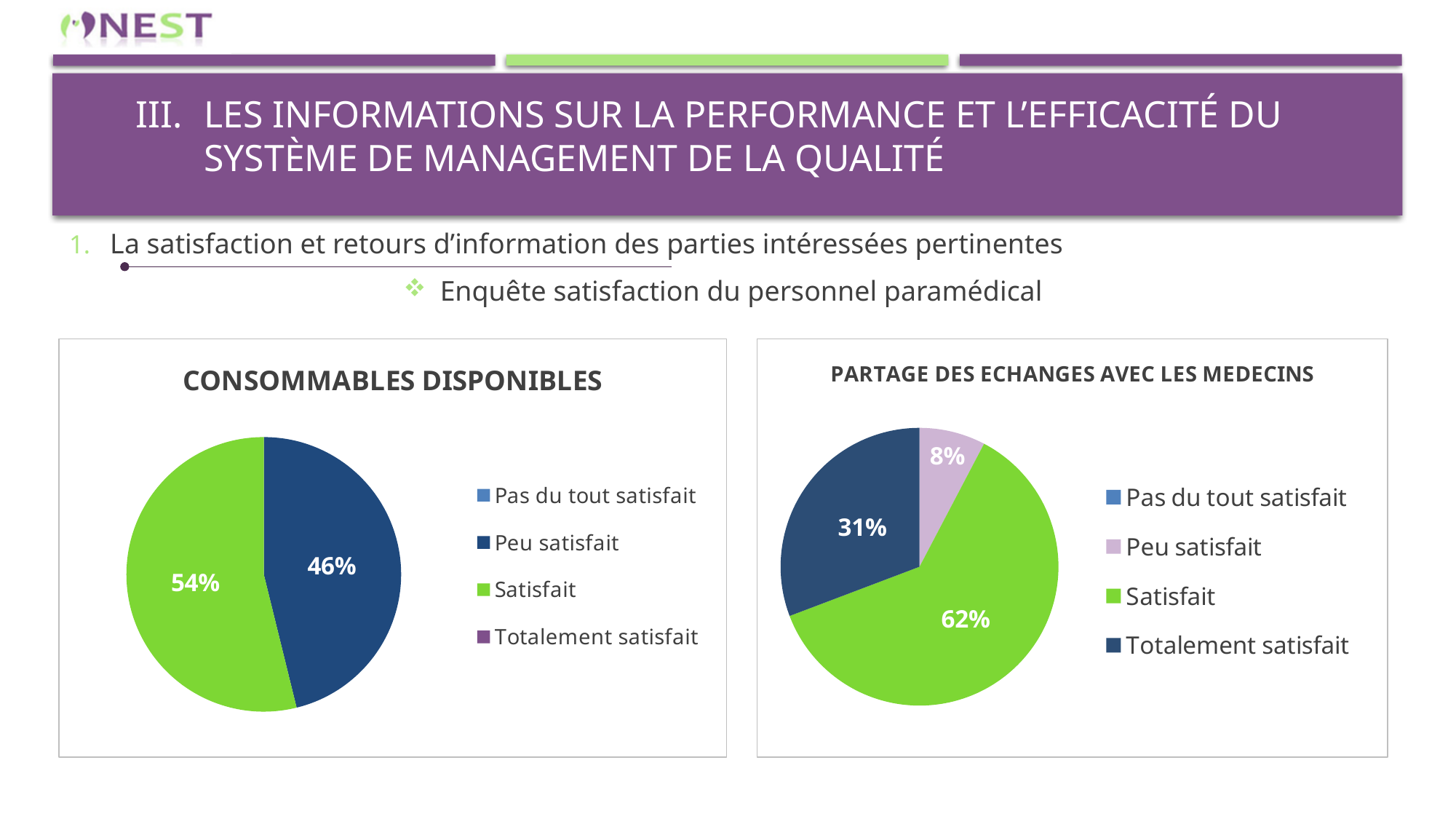
What is the title of the pie chart on the right of the slide? PARTAGE DES ECHANGES AVEC LES MEDECINS In the 'CONSOMMABLES DISPONIBLES' chart, what is the difference in percentage points between 'Satisfait' and 'Peu satisfait'? 8 In the 'PARTAGE DES ECHANGES AVEC LES MEDECINS' chart, which category has the smallest labelled slice? Peu satisfait In the 'CONSOMMABLES DISPONIBLES' chart, what share is labelled for 'Satisfait'? 54% In the 'PARTAGE DES ECHANGES AVEC LES MEDECINS' chart, what share is labelled for 'Satisfait'? 62% In the 'CONSOMMABLES DISPONIBLES' chart, what share is labelled for 'Peu satisfait'? 46% In the 'CONSOMMABLES DISPONIBLES' chart, which category has the largest slice? Satisfait In the 'PARTAGE DES ECHANGES AVEC LES MEDECINS' chart, which is larger: 'Totalement satisfait' or 'Peu satisfait'? Totalement satisfait In the 'PARTAGE DES ECHANGES AVEC LES MEDECINS' chart, what share is labelled for 'Totalement satisfait'? 31% How many entries does the legend of the 'CONSOMMABLES DISPONIBLES' chart list? 4 What type of chart is the 'CONSOMMABLES DISPONIBLES' chart? Pie chart In the 'PARTAGE DES ECHANGES AVEC LES MEDECINS' chart, what share is labelled for 'Peu satisfait'? 8%